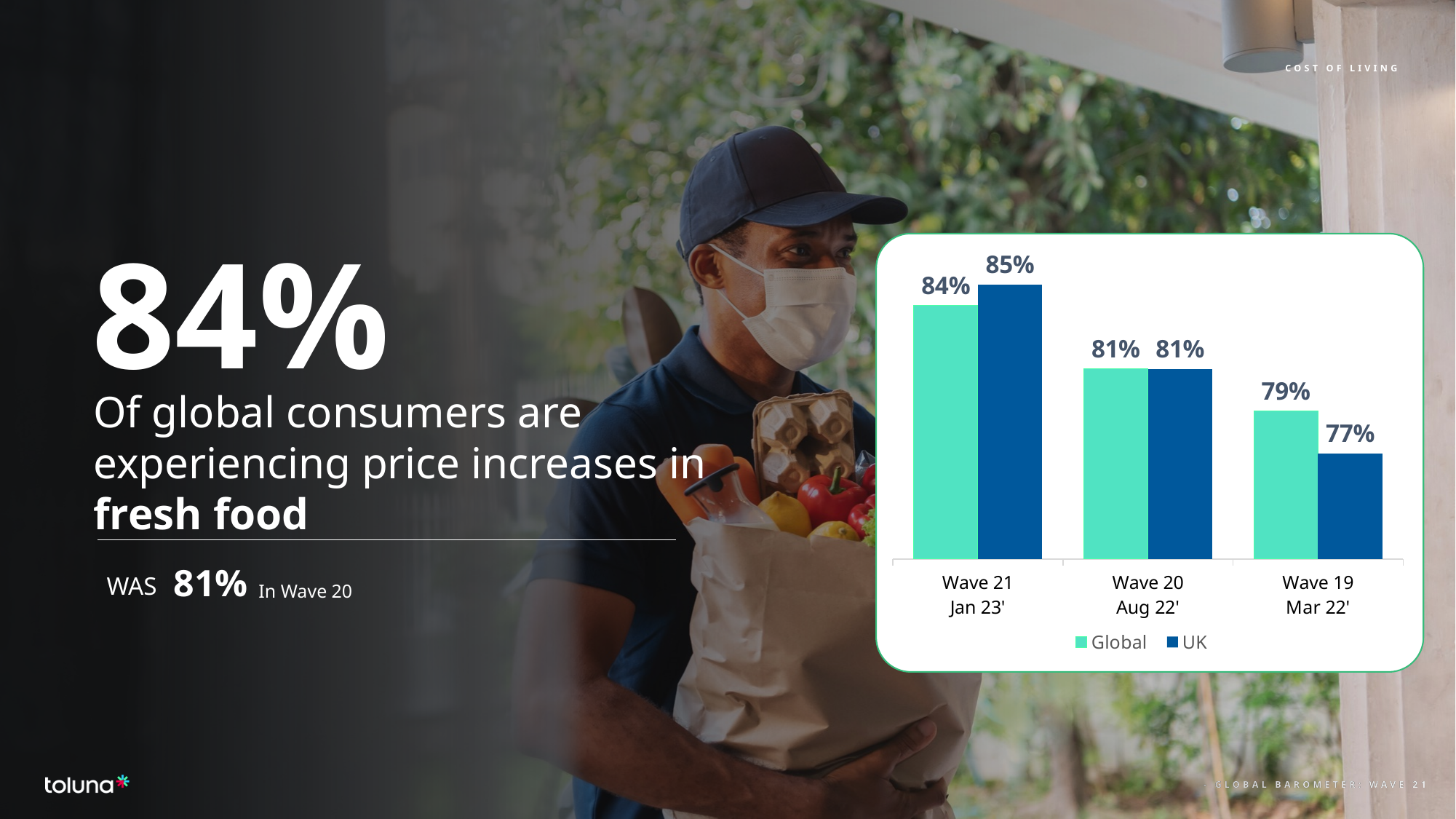
What kind of chart is shown on the slide? Bar chart Which series is shown in dark blue in the chart legend? UK What is the difference between the UK value for Wave 21 and the UK value for Wave 19? 8% Which is larger for Wave 19 (Mar 22'): the Global value or the UK value? Global Which wave has the lowest Global value? Wave 19 (Mar 22') What is the UK value for Wave 21 (Jan 23')? 85% What is the Global value for Wave 21 (Jan 23')? 84% How many waves are shown on the x axis of the chart? 3 Which wave has the highest UK value? Wave 21 (Jan 23') What is the Global value for Wave 20 (Aug 22')? 81% How many series does the chart legend list? 2 What is the UK value for Wave 19 (Mar 22')? 77%